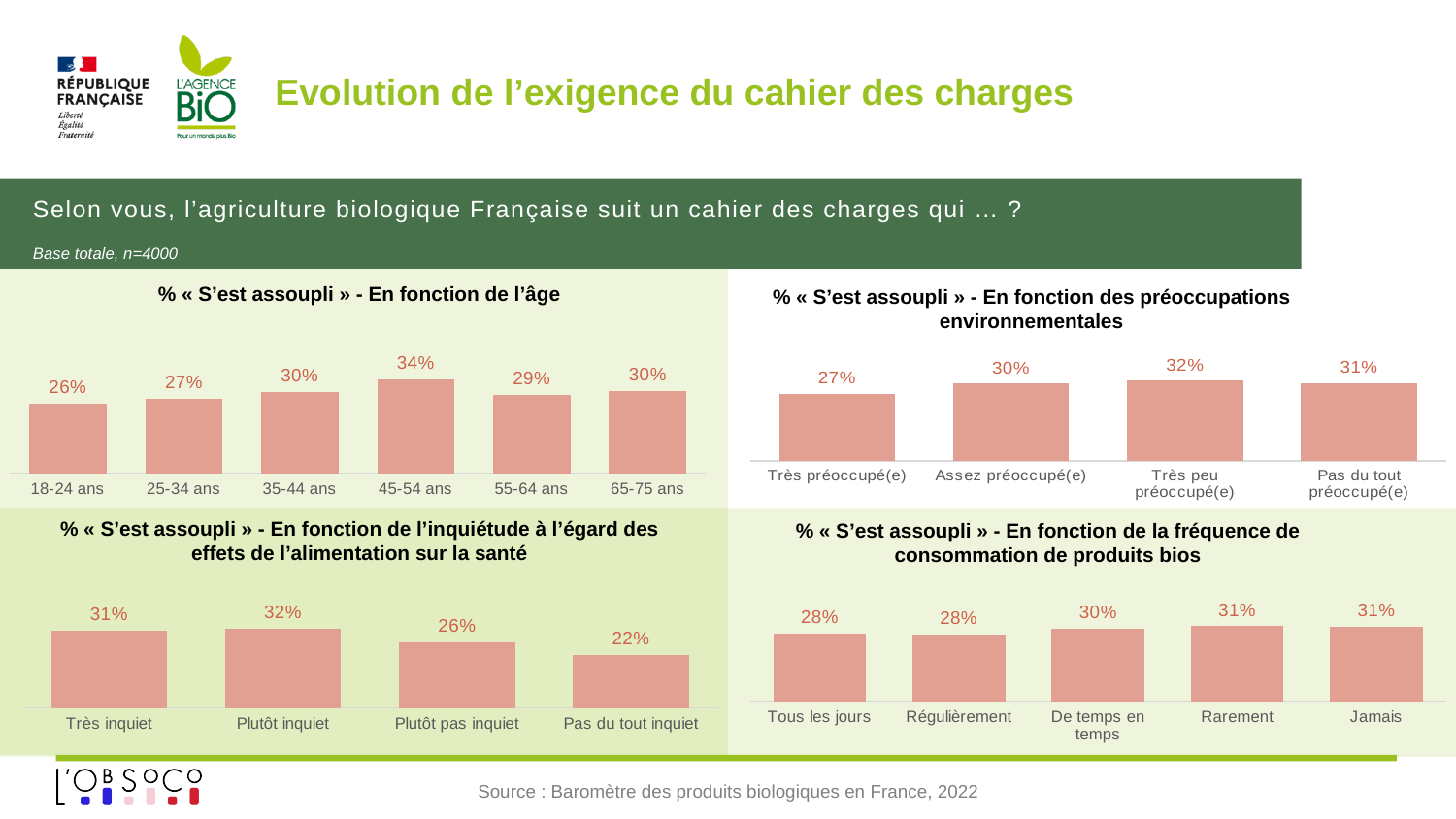
In the chart "% « S'est assoupli » - En fonction de la fréquence de consommation de produits bios", which is larger, the value for Tous les jours or the value for Jamais? Jamais In the chart "% « S'est assoupli » - En fonction de l'inquiétude à l'égard des effets de l'alimentation sur la santé", do the values rise or fall from Plutôt inquiet to Pas du tout inquiet? fall In the chart "% « S'est assoupli » - En fonction de l'inquiétude à l'égard des effets de l'alimentation sur la santé", what is the value for Pas du tout inquiet? 22% In the chart "% « S'est assoupli » - En fonction des préoccupations environnementales", which category has the highest value? Très peu préoccupé(e) In the chart "% « S'est assoupli » - En fonction de la fréquence de consommation de produits bios", what is the value for De temps en temps? 30% In the chart "% « S'est assoupli » - En fonction de l'inquiétude à l'égard des effets de l'alimentation sur la santé", which category has the highest value? Plutôt inquiet In the chart "% « S'est assoupli » - En fonction de l'âge", what is the value for 45-54 ans? 34% In the chart "% « S'est assoupli » - En fonction de l'âge", how many age groups are shown? 6 In the chart "% « S'est assoupli » - En fonction de l'âge", what is the difference between the values for 45-54 ans and 18-24 ans? 8 percentage points In the chart "% « S'est assoupli » - En fonction de l'âge", which age group has the lowest value? 18-24 ans In the chart "% « S'est assoupli » - En fonction des préoccupations environnementales", what is the value for Très préoccupé(e)? 27% What kind of chart is "% « S'est assoupli » - En fonction de la fréquence de consommation de produits bios"? bar chart